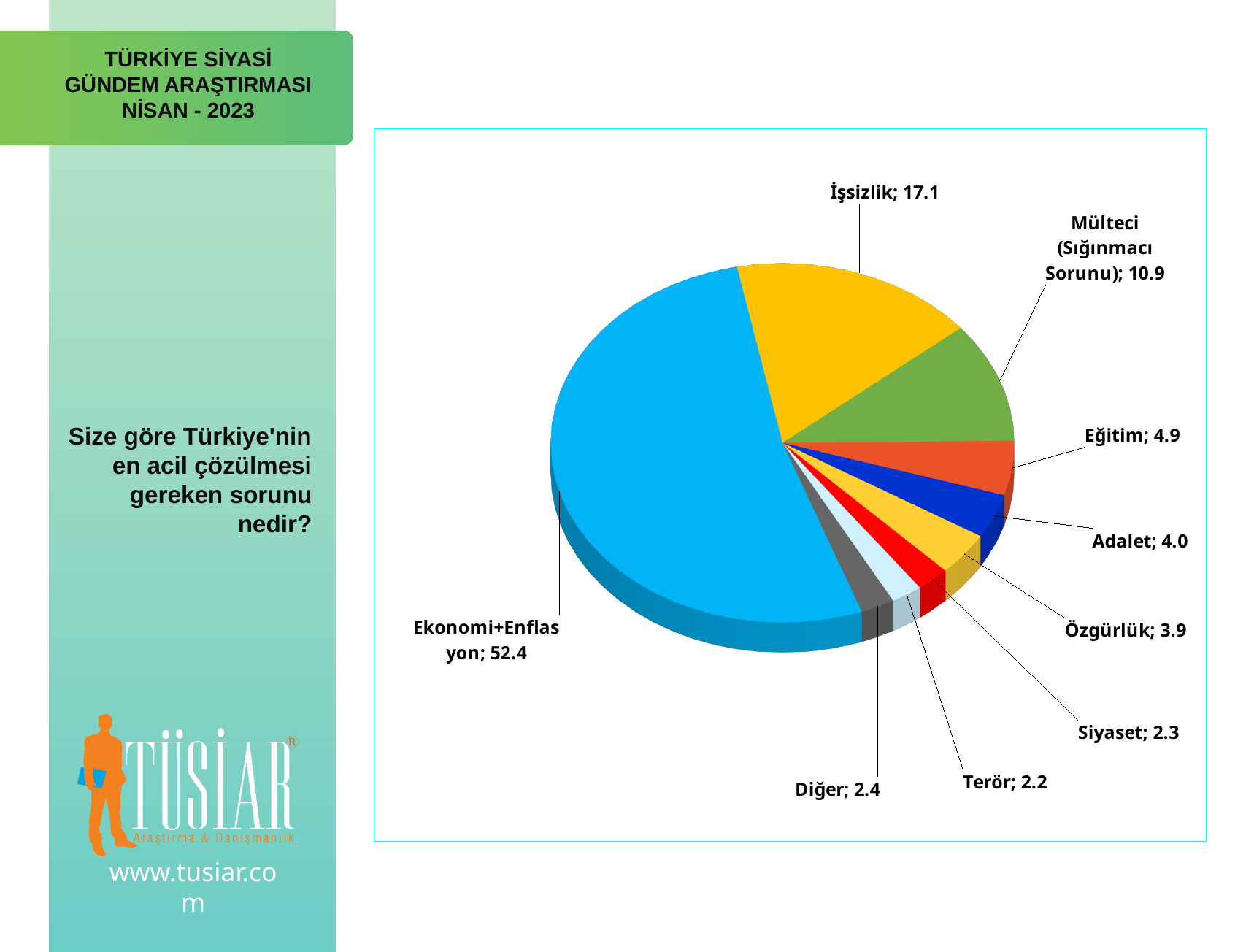
Which category has the smallest slice in the pie chart? Terör What value is shown for İşsizlik in the pie chart? 17.1 How many categories are shown in the pie chart? 9 What kind of chart is shown on the slide? Pie chart What share of the pie does Ekonomi+Enflasyon account for? 52.4 What value is shown for Mülteci (Sığınmacı Sorunu) in the pie chart? 10.9 What value is shown for Eğitim in the pie chart? 4.9 What is the difference between the values for Ekonomi+Enflasyon and İşsizlik? 35.3 Which is larger, the value for Adalet or the value for Diğer? Adalet Which category has the largest slice in the pie chart? Ekonomi+Enflasyon What value is shown for Terör in the pie chart? 2.2 What is the difference between the values for İşsizlik and Mülteci (Sığınmacı Sorunu)? 6.2